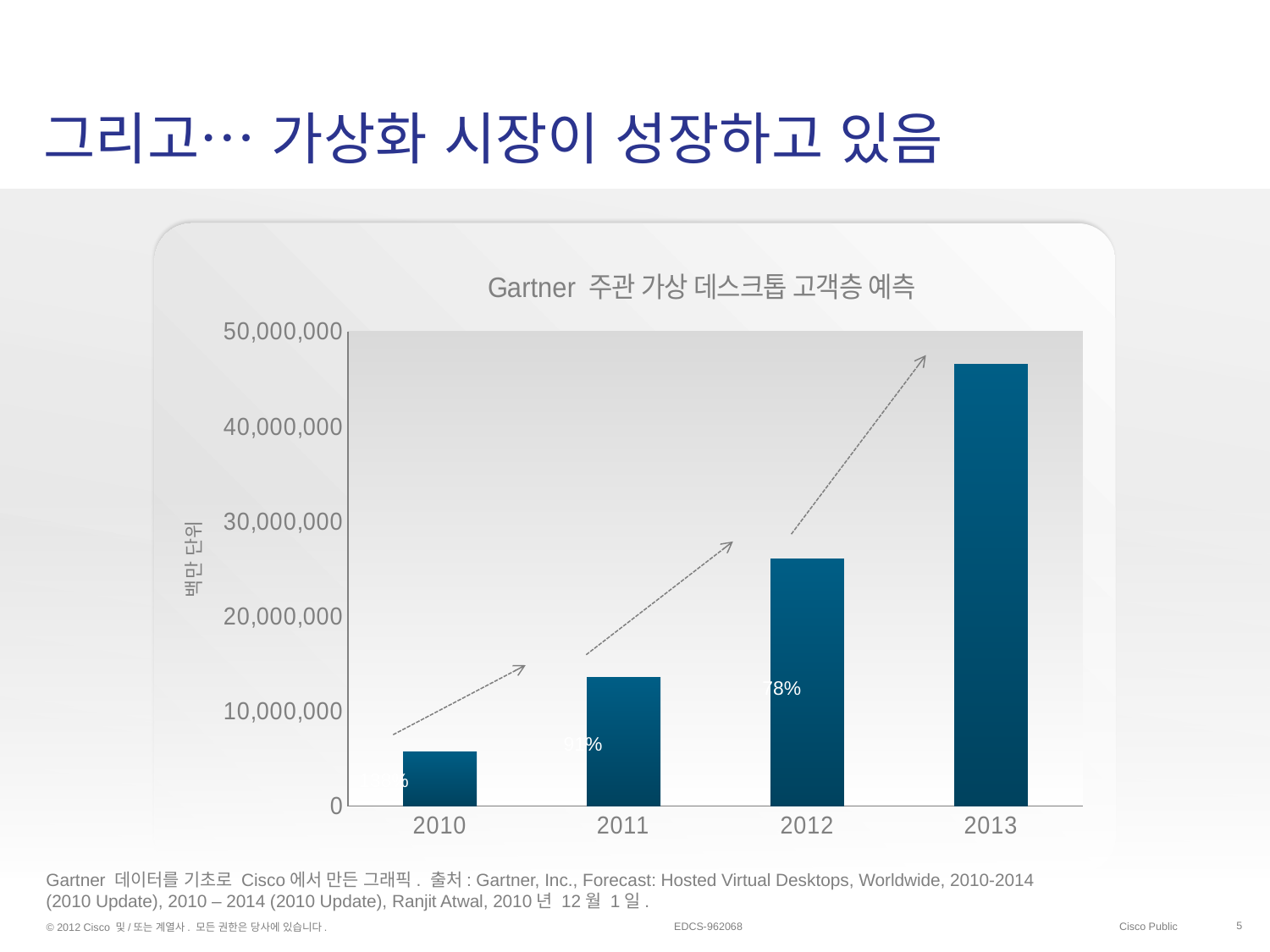
Is the value for 2012 greater or less than 20,000,000? greater Which year has the lowest bar in the chart? 2010 Which is larger, the value for 2011 or the value for 2012? 2012 What kind of chart is shown on the slide? bar chart Is the value for 2010 greater or less than 10,000,000? less Do the values rise or fall from 2010 to 2013? rise What is the title of the chart? Gartner 주관 가상 데스크톱 고객층 예측 How many years (categories) are shown on the x axis of the chart? 4 Which year has the highest bar in the chart? 2013 Is the value for 2011 greater or less than 10,000,000? greater